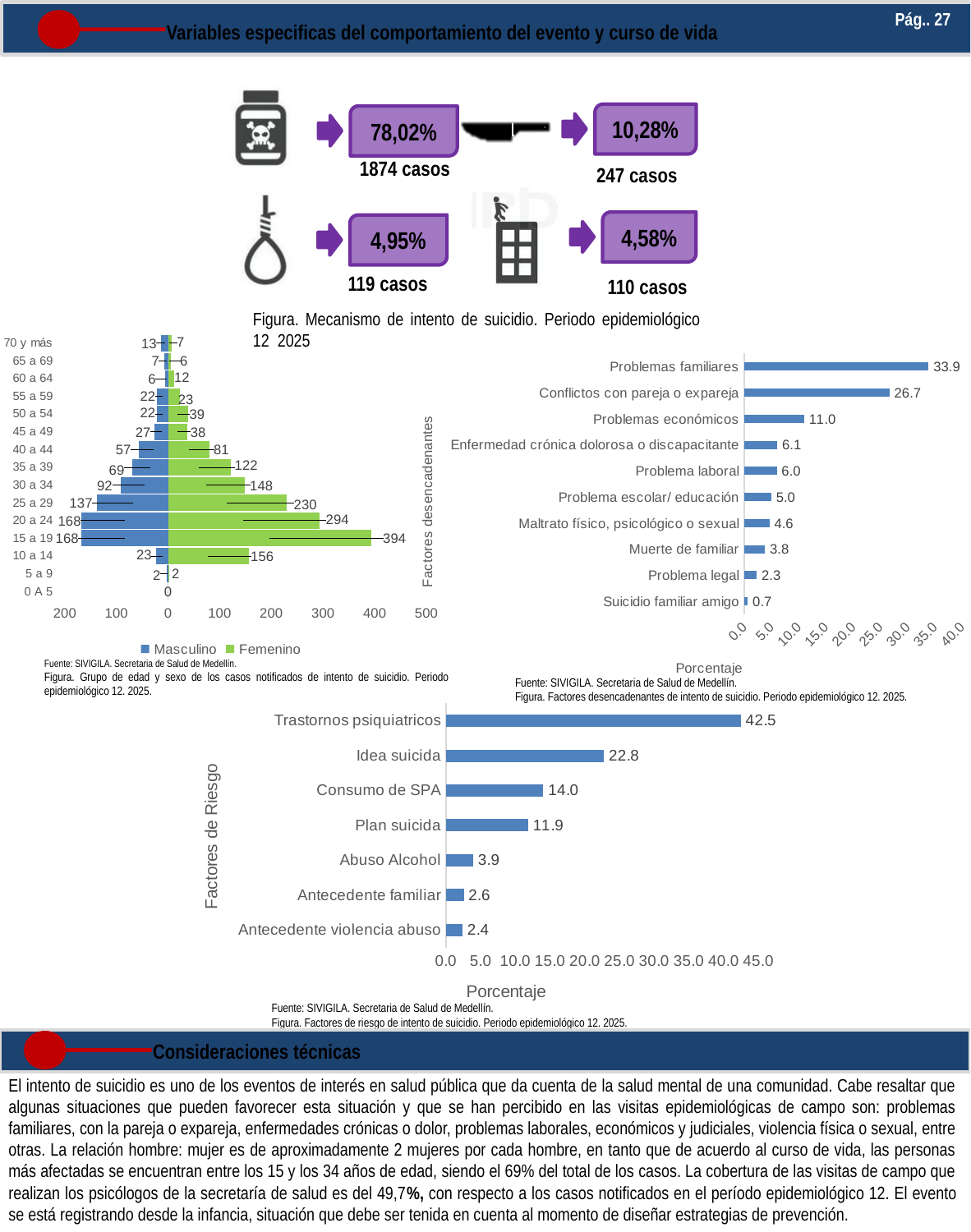
In the chart titled 'Factores desencadenantes de intento de suicidio', what is the value for 'Problemas familiares'? 33.9 In the chart titled 'Factores de riesgo de intento de suicidio', which risk factor has the highest value? Trastornos psiquiatricos In the chart titled 'Factores de riesgo de intento de suicidio', what kind of chart is shown? Bar chart In the chart titled 'Factores desencadenantes de intento de suicidio', how many factors are listed? 10 In the chart titled 'Factores desencadenantes de intento de suicidio', what is the difference between 'Problemas familiares' and 'Conflictos con pareja o expareja'? 7.2 In the chart titled 'Factores de riesgo de intento de suicidio', which is larger: 'Plan suicida' or 'Abuso Alcohol'? Plan suicida In the chart titled 'Grupo de edad y sexo de los casos notificados de intento de suicidio', what is the Femenino value for the '15 a 19' age group? 394 In the chart titled 'Factores de riesgo de intento de suicidio', what is the value for 'Consumo de SPA'? 14.0 In the chart titled 'Factores desencadenantes de intento de suicidio', which factor has the lowest value? Suicidio familiar amigo In the chart titled 'Grupo de edad y sexo de los casos notificados de intento de suicidio', how many series does the legend list? 2 In the chart titled 'Grupo de edad y sexo de los casos notificados de intento de suicidio', what is the difference between the Femenino and Masculino values for the '20 a 24' age group? 126 In the chart titled 'Grupo de edad y sexo de los casos notificados de intento de suicidio', what is the Masculino value for the '25 a 29' age group? 137